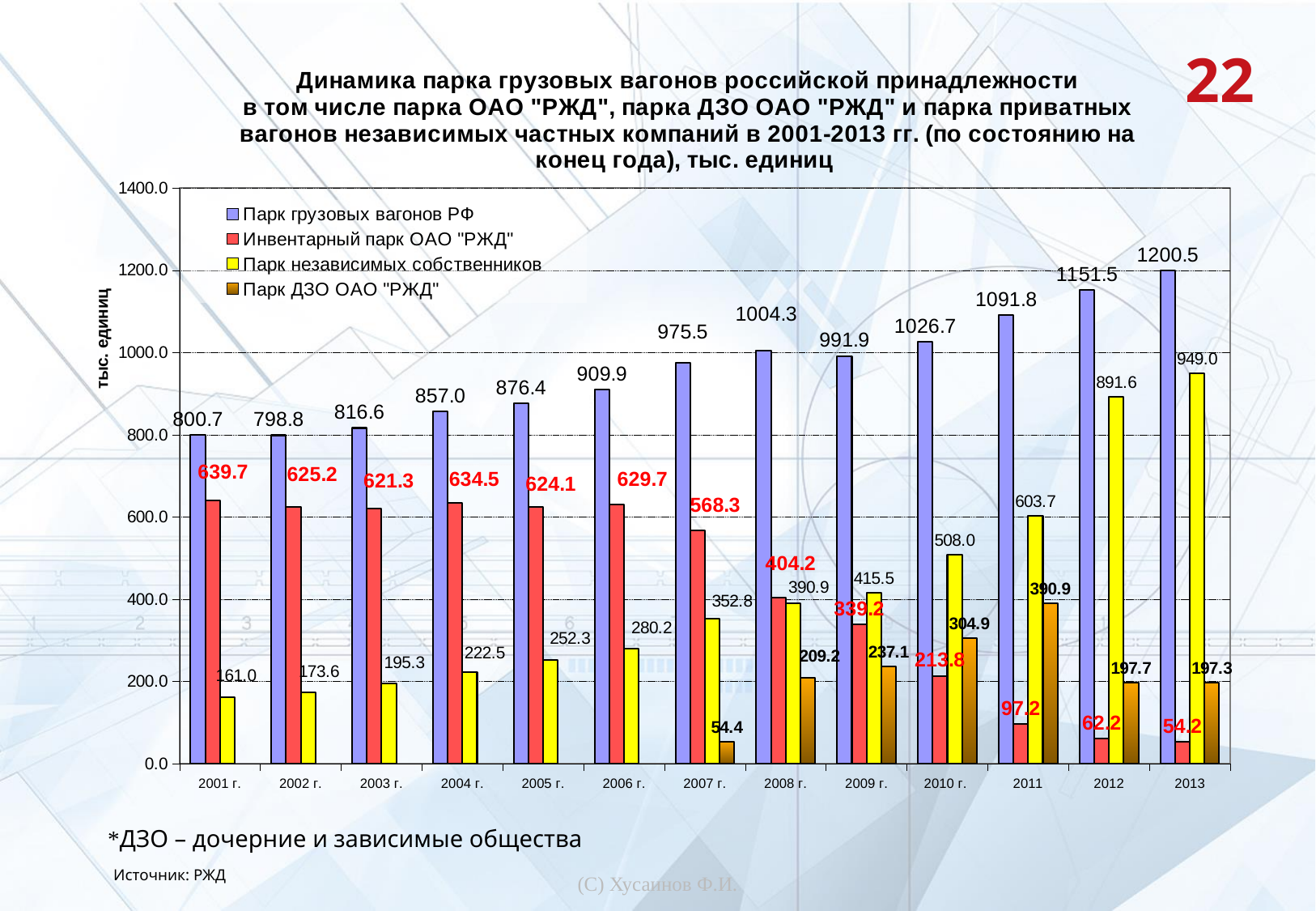
What is the value of Парк грузовых вагонов РФ in 2013? 1200.5 In which year is Инвентарный парк ОАО "РЖД" the lowest? 2013 How many series does the legend list? 4 What is the difference between Парк независимых собственников in 2013 and in 2012? 57.4 By how much did Парк грузовых вагонов РФ increase from 2012 to 2013? 49.0 In 2008 г., which is larger: Инвентарный парк ОАО "РЖД" or Парк независимых собственников? Инвентарный парк ОАО "РЖД" What is the value of Инвентарный парк ОАО "РЖД" in 2001 г.? 639.7 In which year is Парк грузовых вагонов РФ the highest? 2013 What is the value of Парк ДЗО ОАО "РЖД" in 2011? 390.9 What kind of chart is shown on the slide? Bar chart What is the value of Парк независимых собственников in 2010 г.? 508.0 How many years are shown on the x axis of the chart? 13